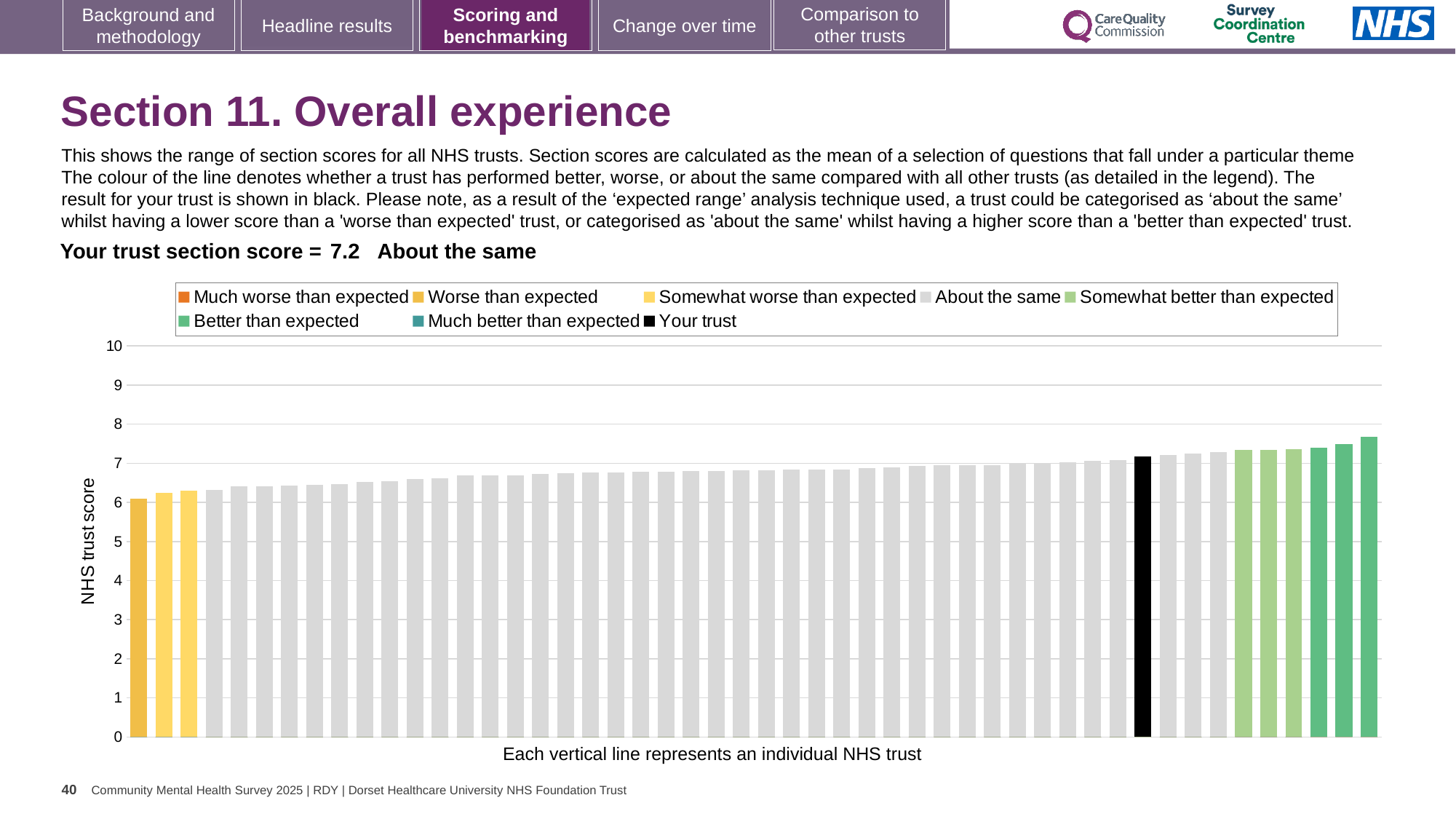
Is the value of the highest bar greater or less than 8? less What kind of chart is shown on the slide? bar chart How many bars are coloured yellow (worse than expected categories) on the chart? 3 Do the bar values rise or fall from left to right along the x axis? rise How many bars are coloured green (better than expected categories) on the chart? 6 Is the value of the black 'Your trust' bar greater or less than 7? greater Is the value of the highest bar greater or less than 7? greater What is the section score for your trust shown on the slide? 7.2 Which category is your trust placed in for this section? About the same How many entries does the chart legend list? 8 What is the label on the vertical axis of the chart? NHS trust score